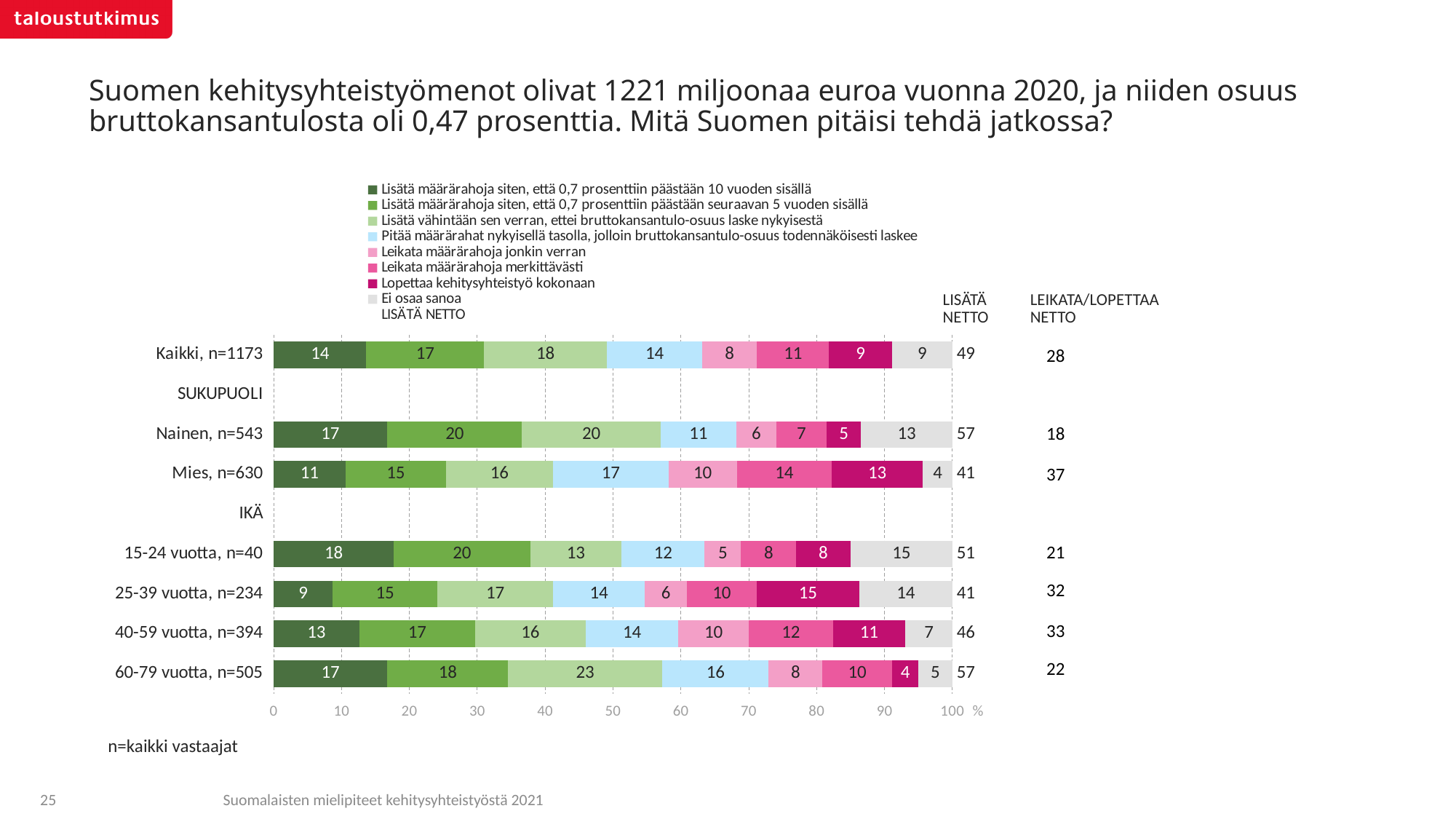
Which respondent group has the highest value in the series "Lopettaa kehitysyhteistyö kokonaan"? 25-39 vuotta, n=234 What kind of chart is shown on the slide? Stacked bar chart How many series does the legend list? 9 How many respondent groups (bars) are plotted in the chart? 7 What is the LISÄTÄ NETTO value for "15-24 vuotta, n=40"? 51 What is the difference between "Mies, n=630" and "Nainen, n=543" in the series "Lopettaa kehitysyhteistyö kokonaan"? 8 Which respondent group has the lowest value in the series "Ei osaa sanoa"? Mies, n=630 What is the LEIKATA/LOPETTAA NETTO value for "Mies, n=630"? 37 In the series "Pitää määrärahat nykyisellä tasolla, jolloin bruttokansantulo-osuus todennäköisesti laskee", which is larger: "Mies, n=630" or "Nainen, n=543"? Mies, n=630 What is the value for "Mies, n=630" in the series "Lopettaa kehitysyhteistyö kokonaan"? 13 What is the value for "60-79 vuotta, n=505" in the series "Lisätä vähintään sen verran, ettei bruttokansantulo-osuus laske nykyisestä"? 23 What is the value for "Kaikki, n=1173" in the series "Lisätä määrärahoja siten, että 0,7 prosenttiin päästään 10 vuoden sisällä"? 14